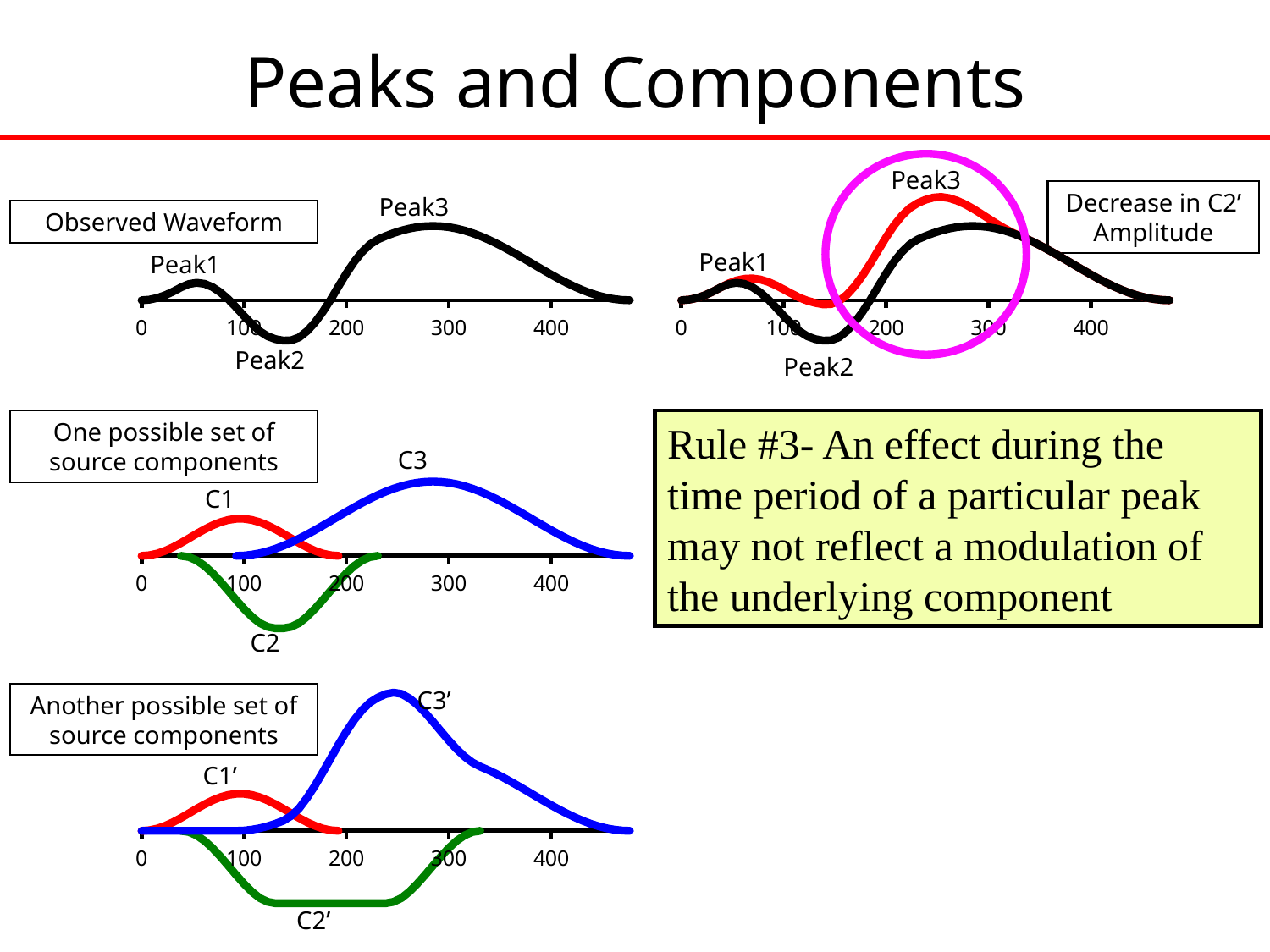
In the top-right chart, which waveform has the higher Peak3, the red one or the black one? red In the 'One possible set of source components' chart, does C3 rise or fall between 300 and 400 on the x axis? fall What kind of chart is the 'Observed Waveform' chart? line chart On the 'Observed Waveform' chart, does Peak3 occur at a time greater or less than 200? greater On the 'Observed Waveform' chart, which labelled peak has the largest amplitude? Peak3 In the 'One possible set of source components' chart, what colour is the C3 component? blue On the 'Observed Waveform' chart, does Peak1 occur at a time greater or less than 100? less How many peaks are labelled on the 'Observed Waveform' chart? 3 On the 'Observed Waveform' chart, which labelled peak dips below the axis? Peak2 In the 'One possible set of source components' chart, what colour is the C2 component? green In the 'Another possible set of source components' chart, which component has the larger amplitude, C1' or C3'? C3' How many components are plotted in the 'One possible set of source components' chart? 3